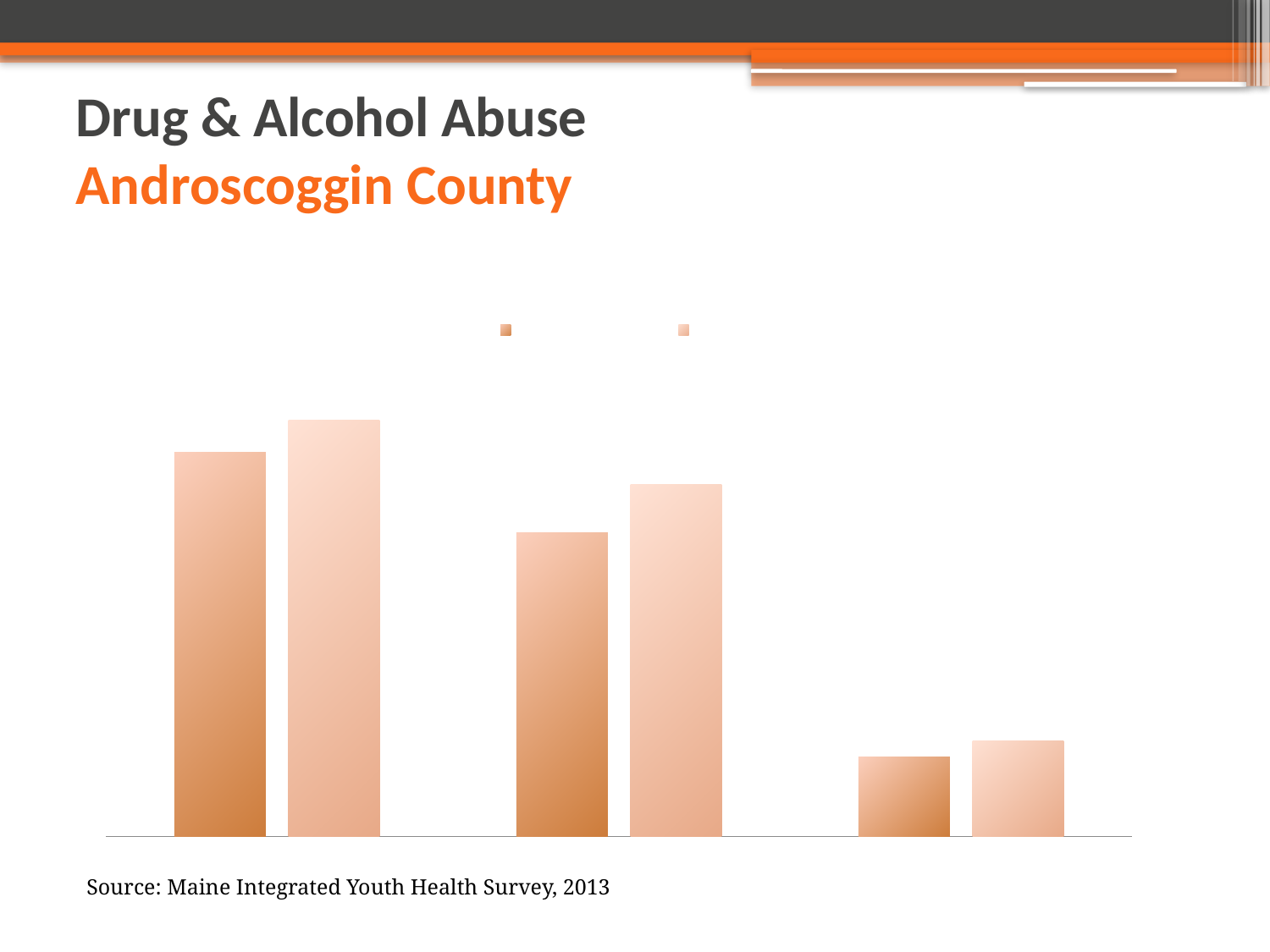
Which group of bars is the tallest: the left, middle, or right group? left What source is cited below the chart? Maine Integrated Youth Health Survey, 2013 What kind of chart is shown on the slide? bar chart In the rightmost group, which bar is taller: the darker orange bar or the lighter orange bar? the lighter orange bar Which is taller: the darker bar in the middle group or the lighter bar in the rightmost group? the darker bar in the middle group Which group of bars is the shortest: the left, middle, or right group? right How many bars are plotted in the chart? 6 Do the bar heights rise or fall moving from the left group to the right group? fall How many series does the legend list? 2 Which county is named in the slide title? Androscoggin County In the leftmost group, which bar is taller: the darker orange bar or the lighter orange bar? the lighter orange bar How many groups of bars does the chart show? 3